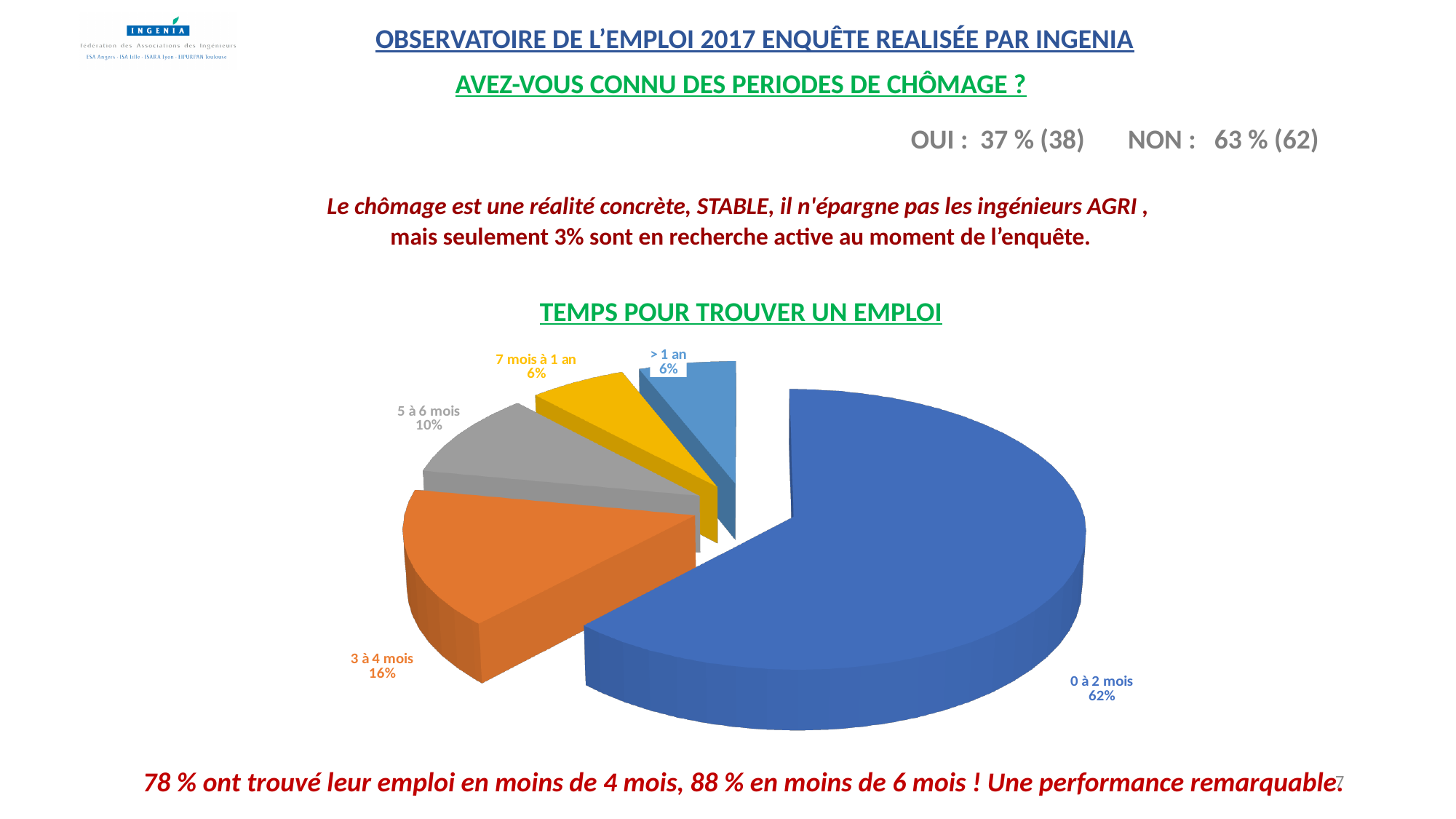
How many slices does the pie chart have? 5 What is the combined share of "3 à 4 mois" and "5 à 6 mois"? 26% What is the value shown for "5 à 6 mois"? 10% What is the difference between the "0 à 2 mois" and "3 à 4 mois" shares? 46% What kind of chart is shown under the title "TEMPS POUR TROUVER UN EMPLOI"? pie chart What colour is the "0 à 2 mois" slice? blue Which category has the largest slice of the pie? 0 à 2 mois Which is larger, the share for "3 à 4 mois" or the share for "5 à 6 mois"? 3 à 4 mois What is the value shown for "> 1 an"? 6% What share of the pie does the "0 à 2 mois" slice represent? 62% What is the value shown for "3 à 4 mois"? 16% What is the value shown for "7 mois à 1 an"? 6%